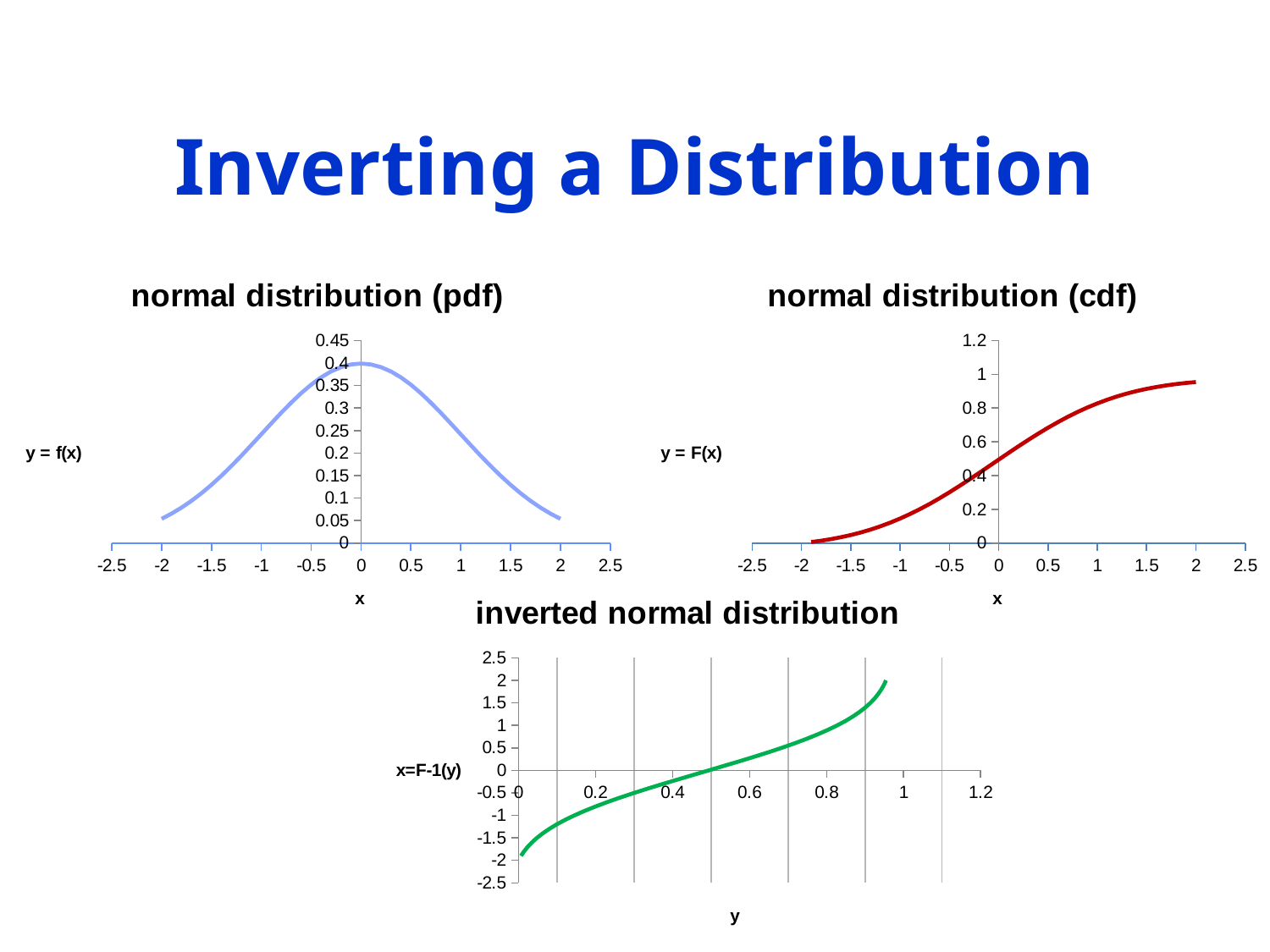
In the "normal distribution (pdf)" chart, at which x value does the curve reach its highest point? 0 What colour is the line in the "normal distribution (cdf)" chart? red In the "normal distribution (cdf)" chart, do the values rise or fall as x increases? rise In the "normal distribution (pdf)" chart, is the value at x = 2 greater or less than 0.1? less How many charts are shown on the slide? 3 What kind of chart is the "normal distribution (pdf)" chart? line chart In the "inverted normal distribution" chart, do the values rise or fall as y increases? rise In the "normal distribution (pdf)" chart, is the value at x = 0 greater or less than 0.3? greater What is the label on the vertical axis of the "inverted normal distribution" chart? x=F-1(y) In the "inverted normal distribution" chart, is the value at y = 0.2 greater or less than 0? less